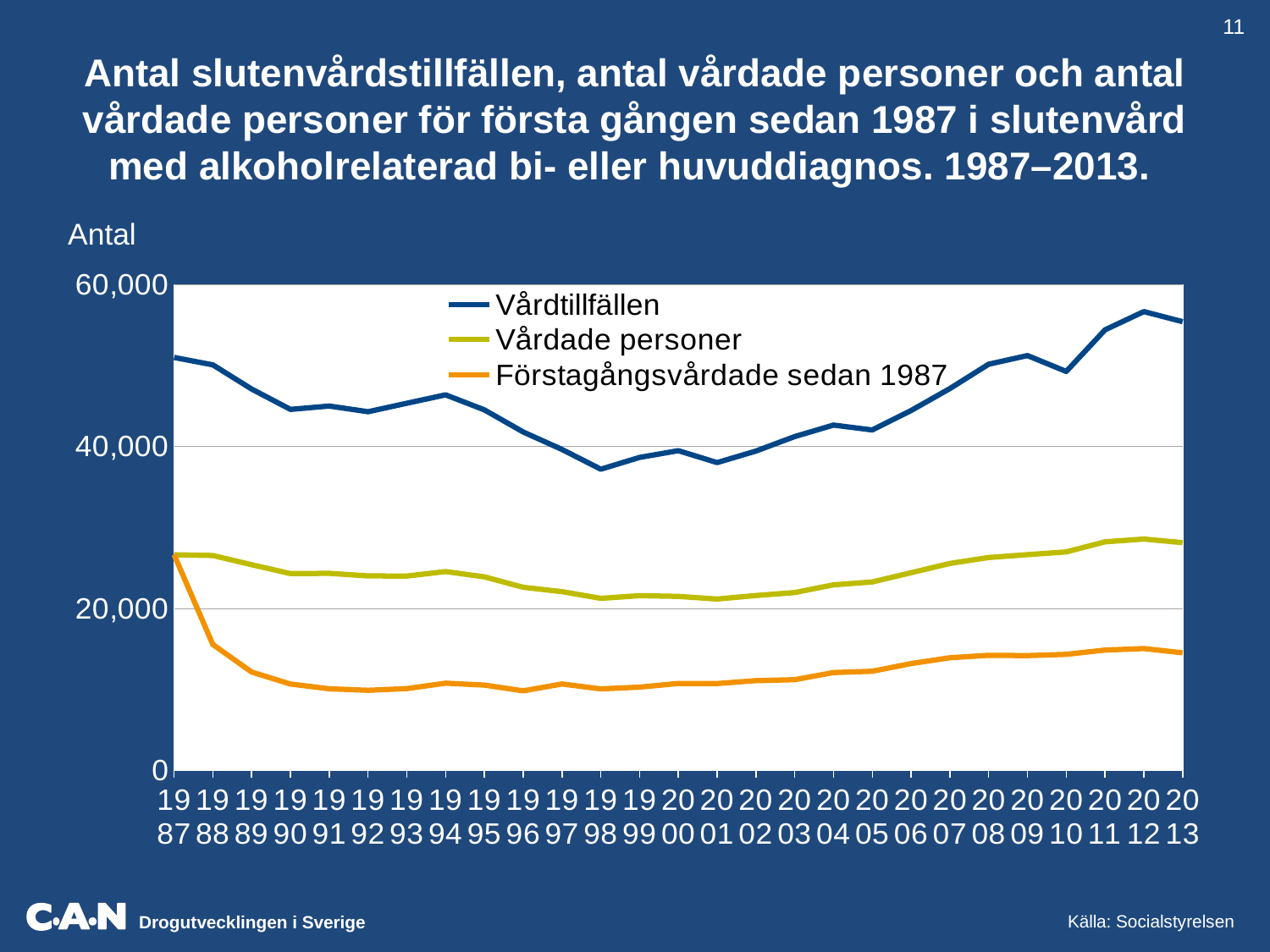
Is the value for Vårdtillfällen in 1998 greater or less than 40,000? less In which year is the Vårdtillfällen series at its highest? 2012 Is the value for Vårdtillfällen in 1987 greater or less than 40,000? greater How many series does the legend list? 3 Is the value for Förstagångsvårdade sedan 1987 in 1996 greater or less than 20,000? less What label is shown on the vertical axis of the chart? Antal What kind of chart is shown on the slide? Line chart In 2013, which is larger: Vårdtillfällen or Vårdade personer? Vårdtillfällen How many years are plotted along the x axis? 27 In which year is the Förstagångsvårdade sedan 1987 series at its highest? 1987 Does the Förstagångsvårdade sedan 1987 series rise or fall between 1987 and 1990? fall